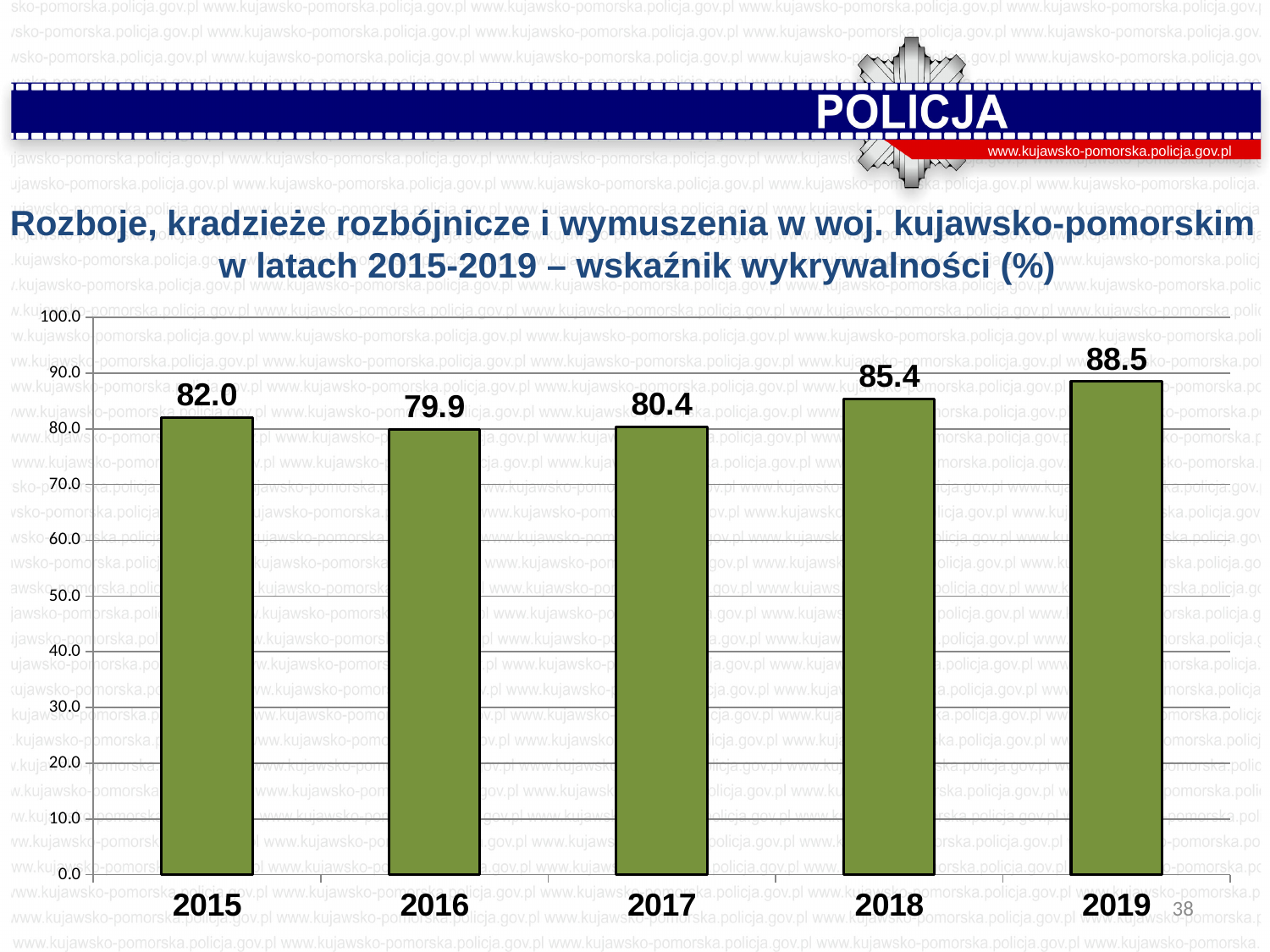
Do the values rise or fall from 2017 to 2019? rise What is the value shown for 2019? 88.5 What is the difference between the values for 2015 and 2016? 2.1 What is the difference between the values for 2019 and 2018? 3.1 Which year has the highest detection rate? 2019 Which is larger, the value for 2018 or the value for 2017? 2018 What is the value shown for 2017? 80.4 What is the detection rate (wskaźnik wykrywalności) for 2015? 82.0 What kind of chart is shown on the slide? bar chart How many years are shown on the x axis? 5 Is the value for 2016 greater or less than 90.0? less Which year has the lowest detection rate? 2016